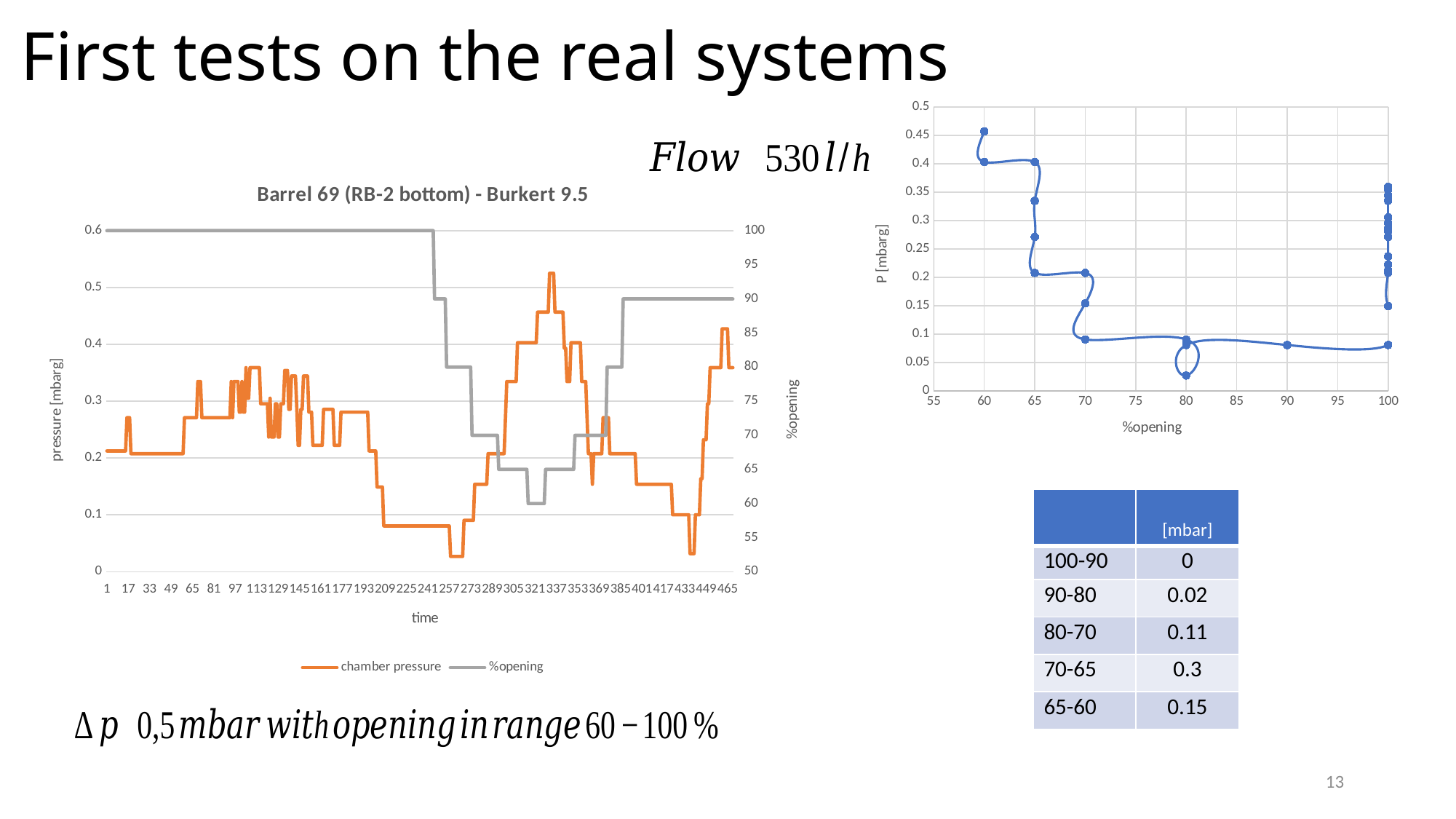
In the chart on the right of the slide, is the P [mbarg] value at 90 %opening greater or less than 0.1? less What kind of chart is the chart on the left (Barrel 69)? line chart What is the title of the chart on the left of the slide? Barrel 69 (RB-2 bottom) - Burkert 9.5 In the chart on the left (Barrel 69), is the lowest chamber pressure value greater or less than 0.1? less In the chart on the left (Barrel 69), is the highest chamber pressure value greater or less than 0.5? greater In the chart on the left (Barrel 69), what is the %opening value at the start of the time axis? 100 In the chart on the right of the slide, does the pressure P [mbarg] generally rise or fall as %opening increases from 60 to 90? fall In the chart on the right of the slide, what is the label of the x axis? %opening In the chart on the left (Barrel 69), how many series does the legend list? 2 In the chart on the left (Barrel 69), what is the lowest %opening value reached? 60 In the chart on the left (Barrel 69), what are the two legend entries? chamber pressure, %opening